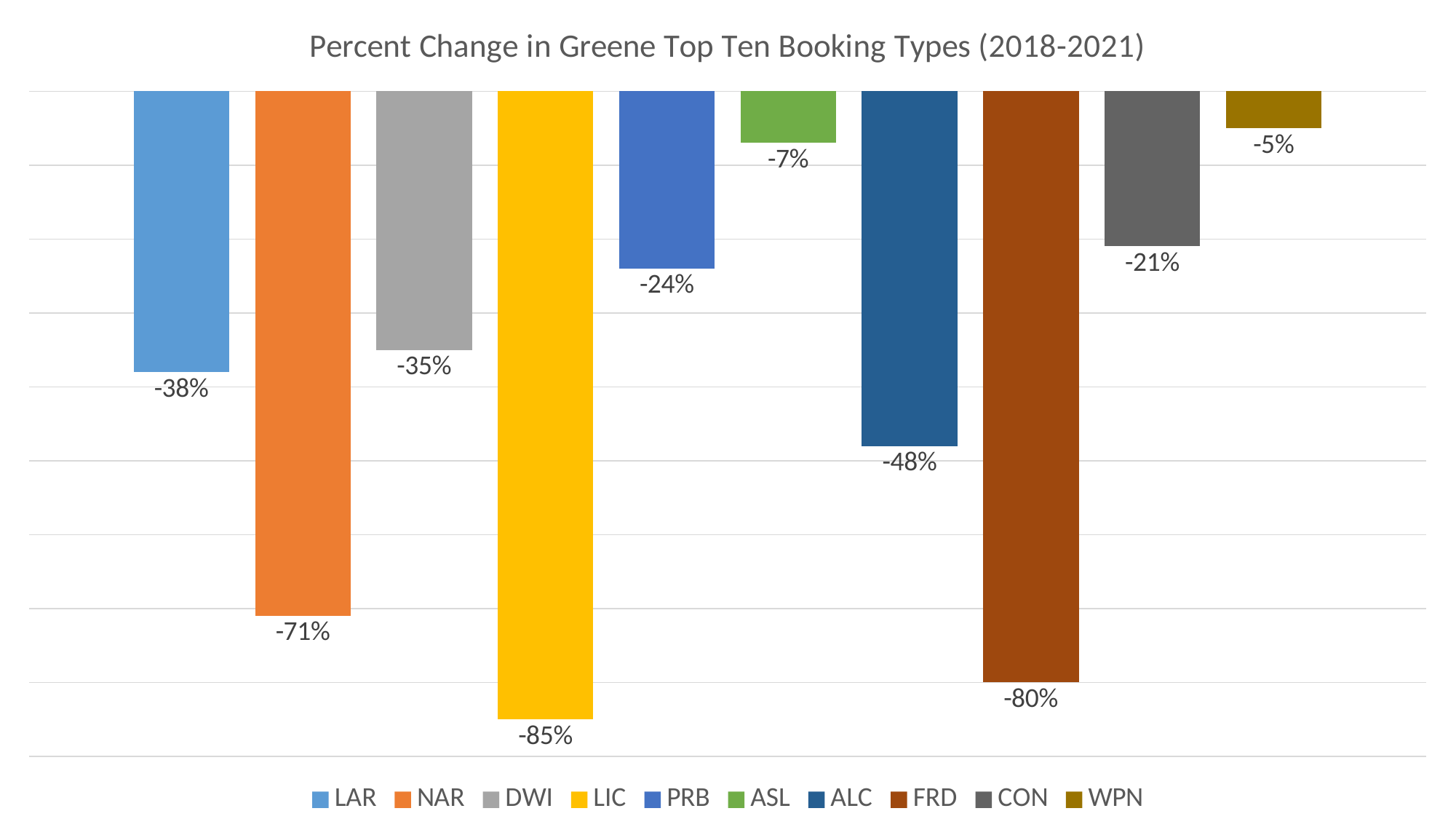
What is the difference in percentage points between the percent change for NAR and LAR? 33 percentage points Which booking type shows the largest percent decrease? LIC What kind of chart is shown on the slide? Bar chart What is the percent change for LIC? -85% Which booking type had the larger percent decrease, NAR or FRD? FRD How many entries does the legend list? 10 Which booking type had the larger percent decrease, DWI or PRB? DWI Which booking type shows the smallest percent decrease? WPN What is the percent change for CON? -21% What is the difference in percentage points between the percent change for LIC and FRD? 5 percentage points How many booking types are plotted in the chart? 10 What is the percent change for ASL? -7%